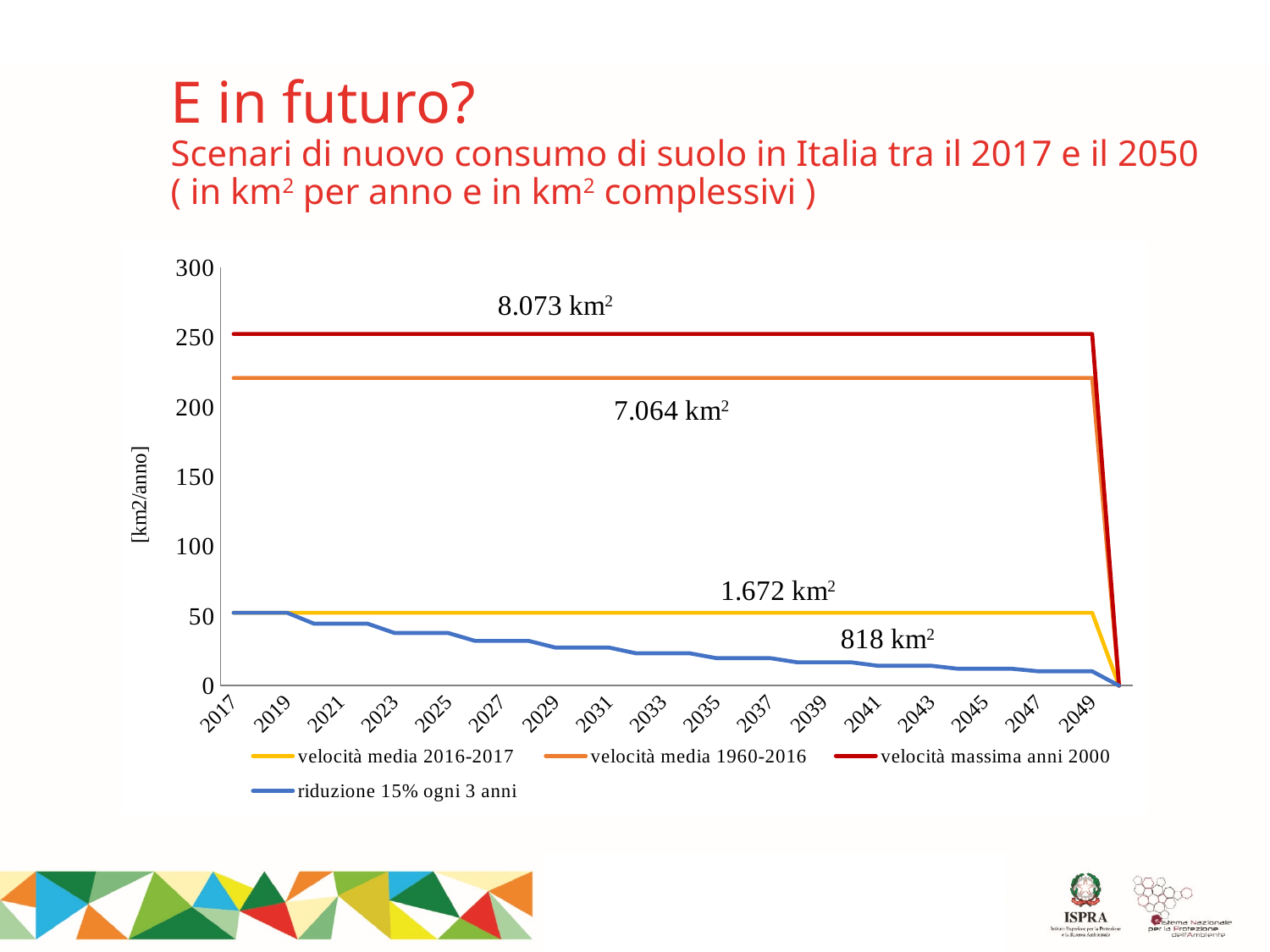
Does the 'riduzione 15% ogni 3 anni' line rise or fall between 2017 and 2049? fall Is the value for 'velocità media 1960-2016' in 2040 greater or less than 250? less Which is larger in 2035: the value for 'velocità media 1960-2016' or for 'velocità media 2016-2017'? velocità media 1960-2016 What cumulative total is annotated above the 'velocità massima anni 2000' line? 8.073 km² What cumulative total is annotated for the 'riduzione 15% ogni 3 anni' scenario? 818 km² What kind of chart is shown on the slide? line chart Which series reaches the lowest values before 2050? riduzione 15% ogni 3 anni Which series is plotted at the highest level on the chart? velocità massima anni 2000 How many series does the chart legend list? 4 What is the label on the vertical axis of the chart? [km2/anno] Is the value for 'velocità media 2016-2017' in 2030 greater or less than 100? less Is the value for 'velocità massima anni 2000' in 2030 greater or less than 200? greater